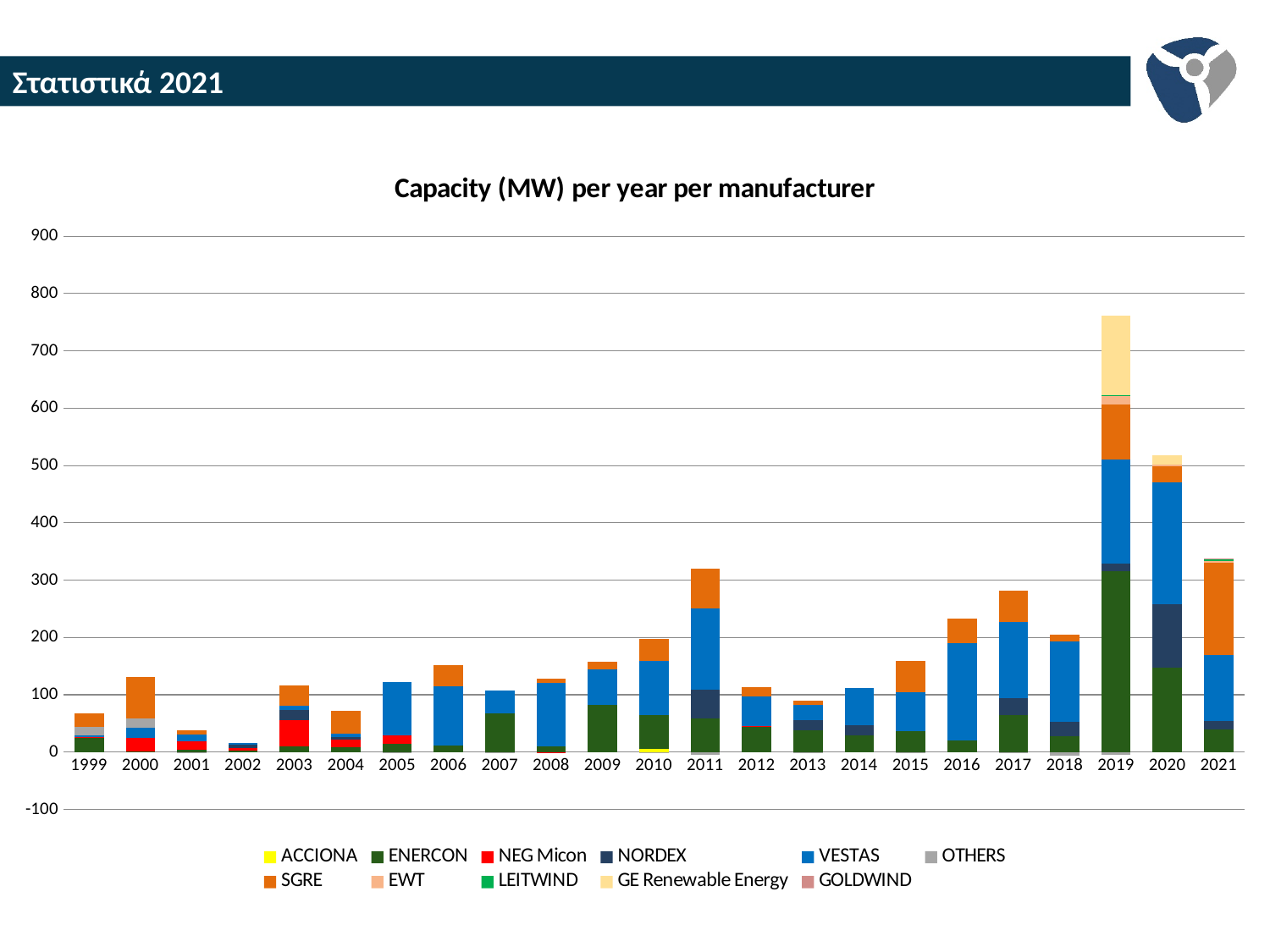
Is the total capacity for 2013 greater or less than 100? less How many years are shown on the x axis? 23 Which year has a larger total capacity, 2011 or 2012? 2011 Which year has a larger total capacity, 2019 or 2020? 2019 Is the total capacity for 2016 greater or less than 200? greater Which year has the highest total capacity? 2019 Which year has the lowest total capacity? 2002 What type of chart is shown on the slide? Stacked bar chart Is the total capacity for 2019 greater or less than 700? greater What is the title of the chart? Capacity (MW) per year per manufacturer How many manufacturers (series) does the legend list? 11 Do the total capacities rise or fall from 2019 to 2021? fall